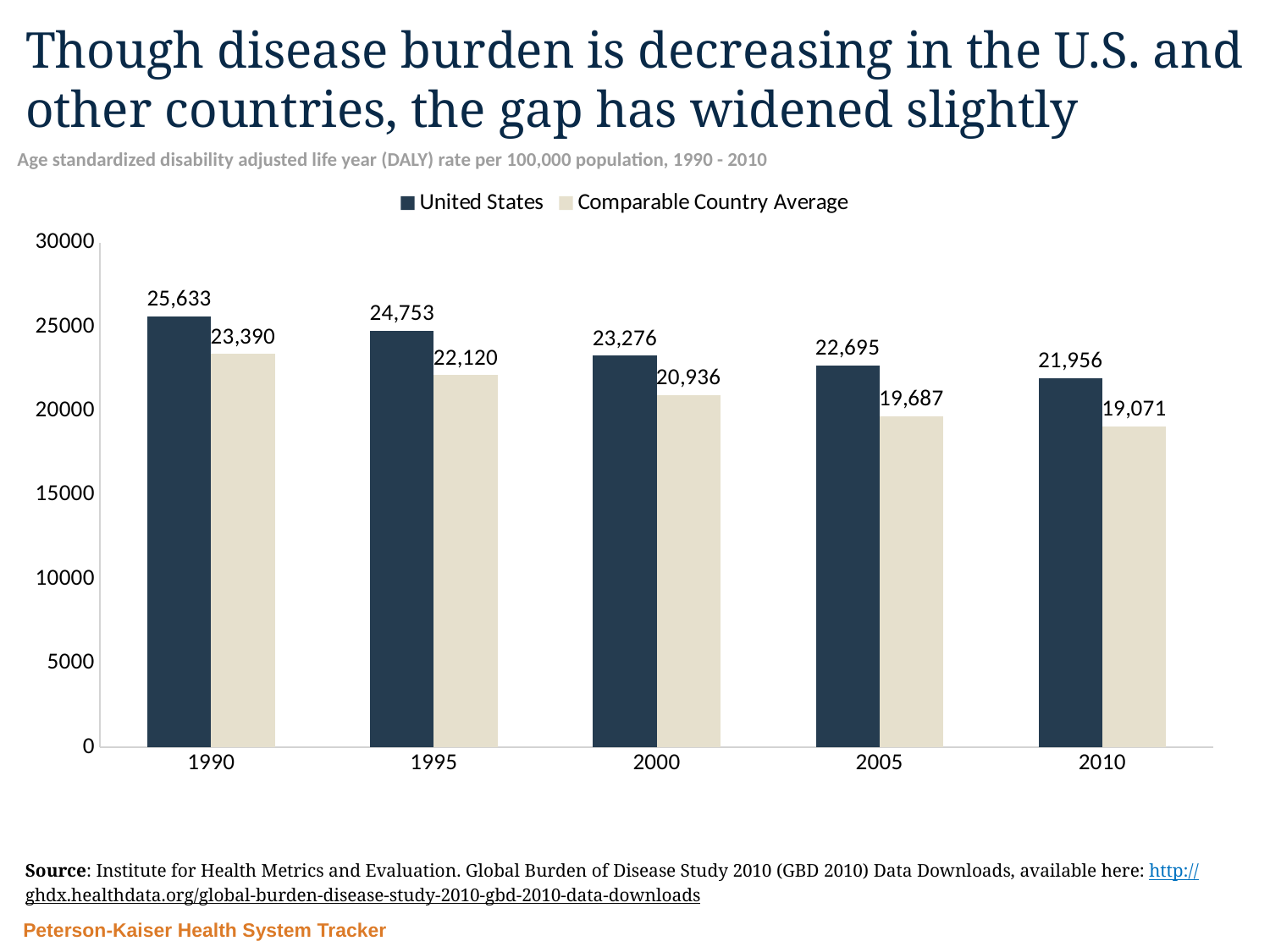
In which year is the Comparable Country Average value lowest? 2010 What kind of chart is shown on the slide? Bar chart What is the difference between the United States and Comparable Country Average values in 1990? 2,243 Is the Comparable Country Average value in 2005 greater or less than 20000? less What is the difference between the United States and Comparable Country Average values in 2010? 2,885 What is the Comparable Country Average value in 2000? 20,936 What is the Comparable Country Average value in 2010? 19,071 Which is larger in 2005, the United States value or the Comparable Country Average value? United States How many series does the legend list? 2 In which year is the United States value highest? 1990 What is the United States DALY rate in 1990? 25,633 How many years are shown on the x axis? 5